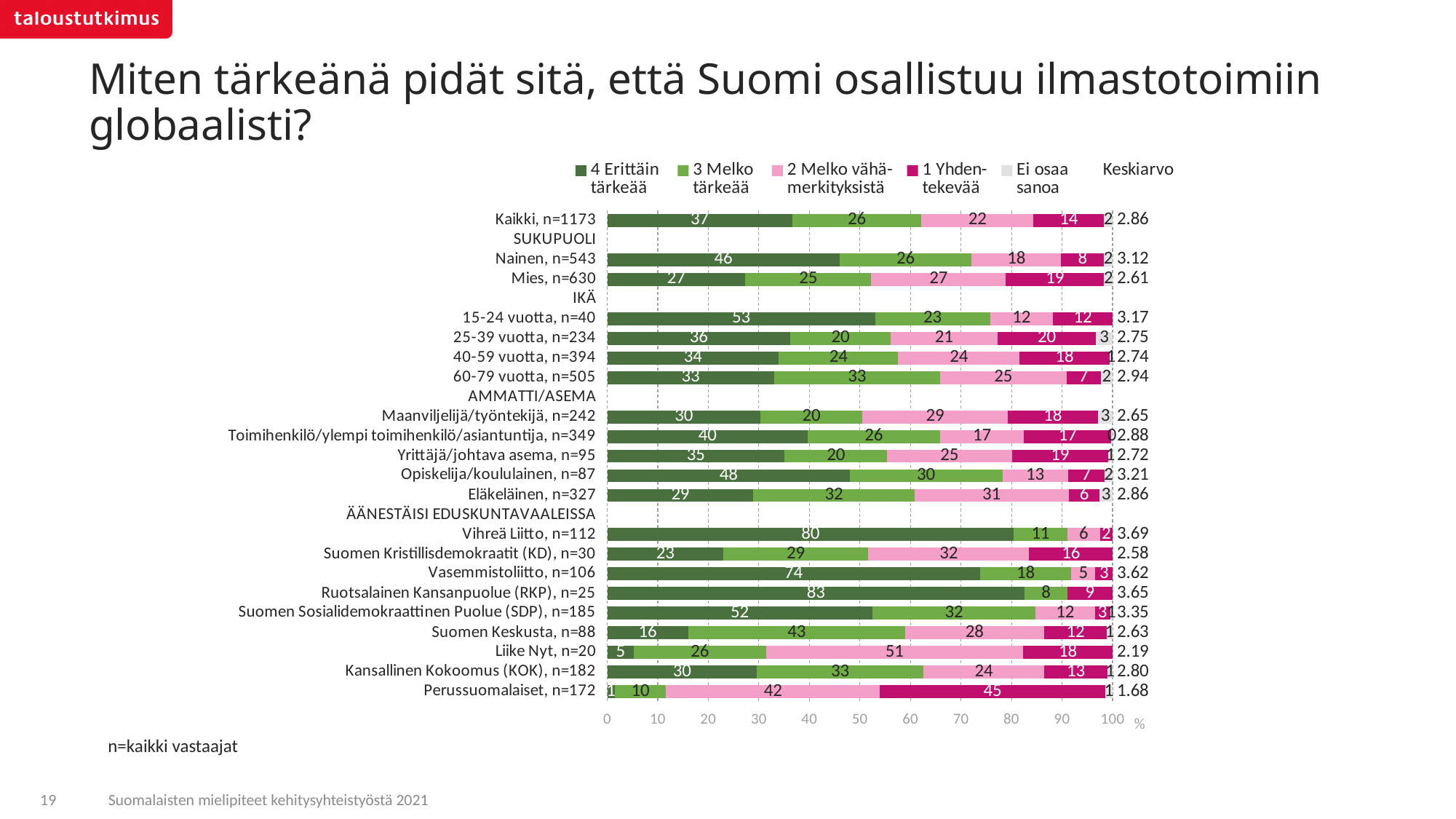
What is the Keskiarvo (mean) value shown for Kaikki, n=1173? 2.86 What percentage of Liike Nyt voters (n=20) answered "2 Melko vähämerkityksistä"? 51 Which group has the highest Keskiarvo (mean) value? Vihreä Liitto, n=112 Which group has the highest share of "4 Erittäin tärkeää" responses? Ruotsalainen Kansanpuolue (RKP), n=25 How many respondent groups (bars) are plotted in the chart? 21 What type of chart is shown on the slide? Stacked bar chart What percentage of all respondents (Kaikki, n=1173) answered "4 Erittäin tärkeää"? 37 What percentage of Eläkeläinen respondents (n=327) answered "3 Melko tärkeää"? 32 What is the difference in the "4 Erittäin tärkeää" share between Nainen (n=543) and Mies (n=630)? 19 What percentage of Perussuomalaiset voters (n=172) answered "1 Yhdentekevää"? 45 Which group has the lowest Keskiarvo (mean) value? Perussuomalaiset, n=172 Which has a larger "4 Erittäin tärkeää" share: Vasemmistoliitto (n=106) or Suomen Sosialidemokraattinen Puolue (SDP) (n=185)? Vasemmistoliitto, n=106